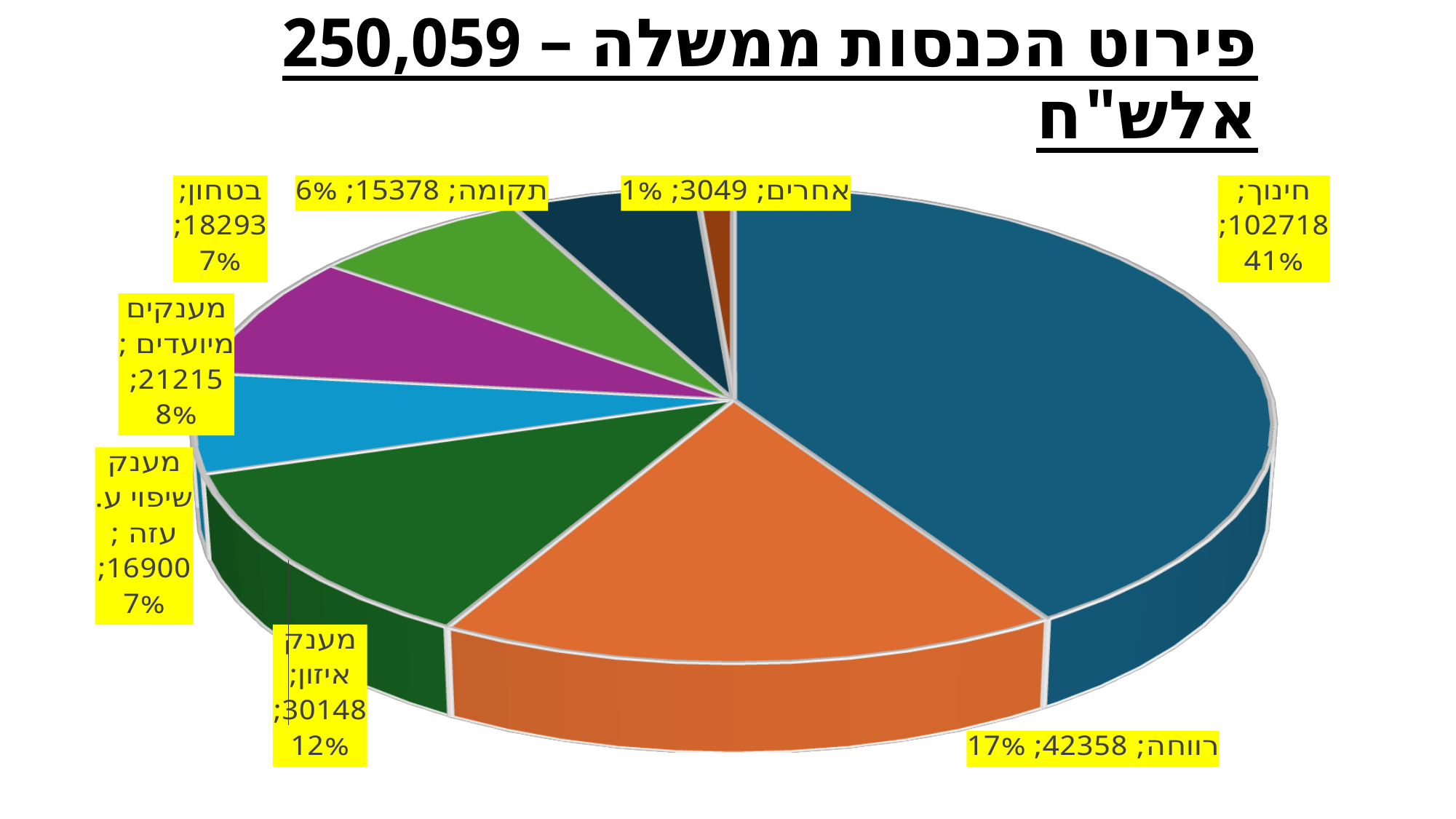
What kind of chart is shown on the slide? pie chart What percentage share does מענקים מיועדים have? 8% Which is larger, the value for בטחון or the value for תקומה? בטחון What is the value for מענק שיפוי ע. עזה? 16900 What total amount is stated in the chart title? 250,059 Which category has the smallest slice? אחרים Which category has the largest slice? חינוך How many slices does the pie chart have? 8 What is the value for מענק איזון? 30148 What is the value for חינוך? 102718 What percentage share does רווחה have? 17% What is the difference between the values for חינוך and רווחה? 60360